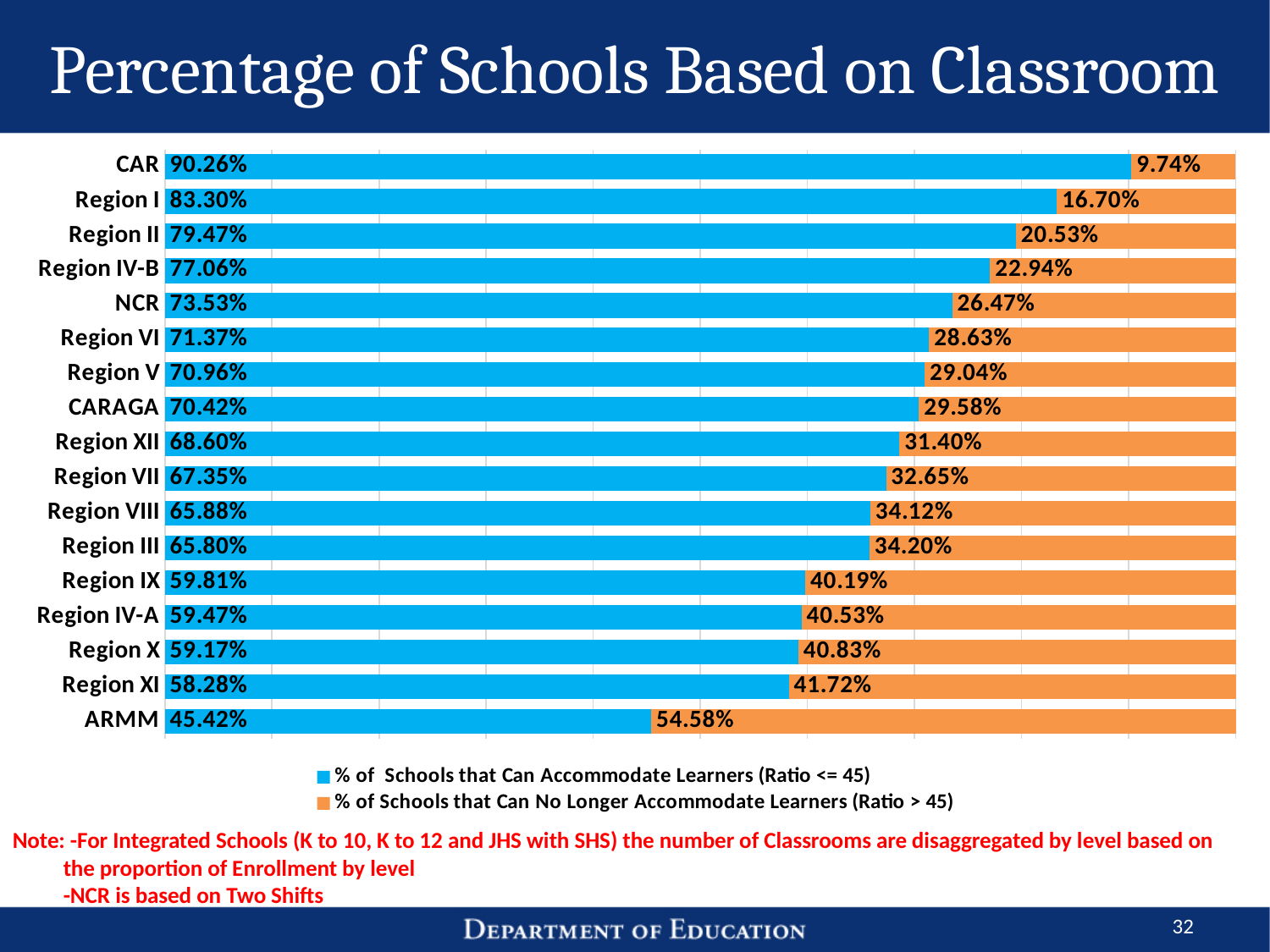
How many regions are shown in the chart? 17 Which region has the highest percentage of schools that can no longer accommodate learners (Ratio > 45)? ARMM Which is larger: the percentage of schools that can accommodate learners in Region VI or in Region IX? Region VI What is the value for NCR in the '% of Schools that Can No Longer Accommodate Learners (Ratio > 45)' series? 26.47% How many series does the legend list? 2 Which region has the highest percentage of schools that can accommodate learners (Ratio <= 45)? CAR What type of chart is shown on the slide? Stacked bar chart What is the total of the two series for Region XII? 100.00% What percentage of schools in ARMM can no longer accommodate learners (Ratio > 45)? 54.58% What is the difference between Region I and Region II in the percentage of schools that can accommodate learners (Ratio <= 45)? 3.83% What percentage of schools in CAR can accommodate learners (Ratio <= 45)? 90.26% Which region has the lowest percentage of schools that can accommodate learners (Ratio <= 45)? ARMM